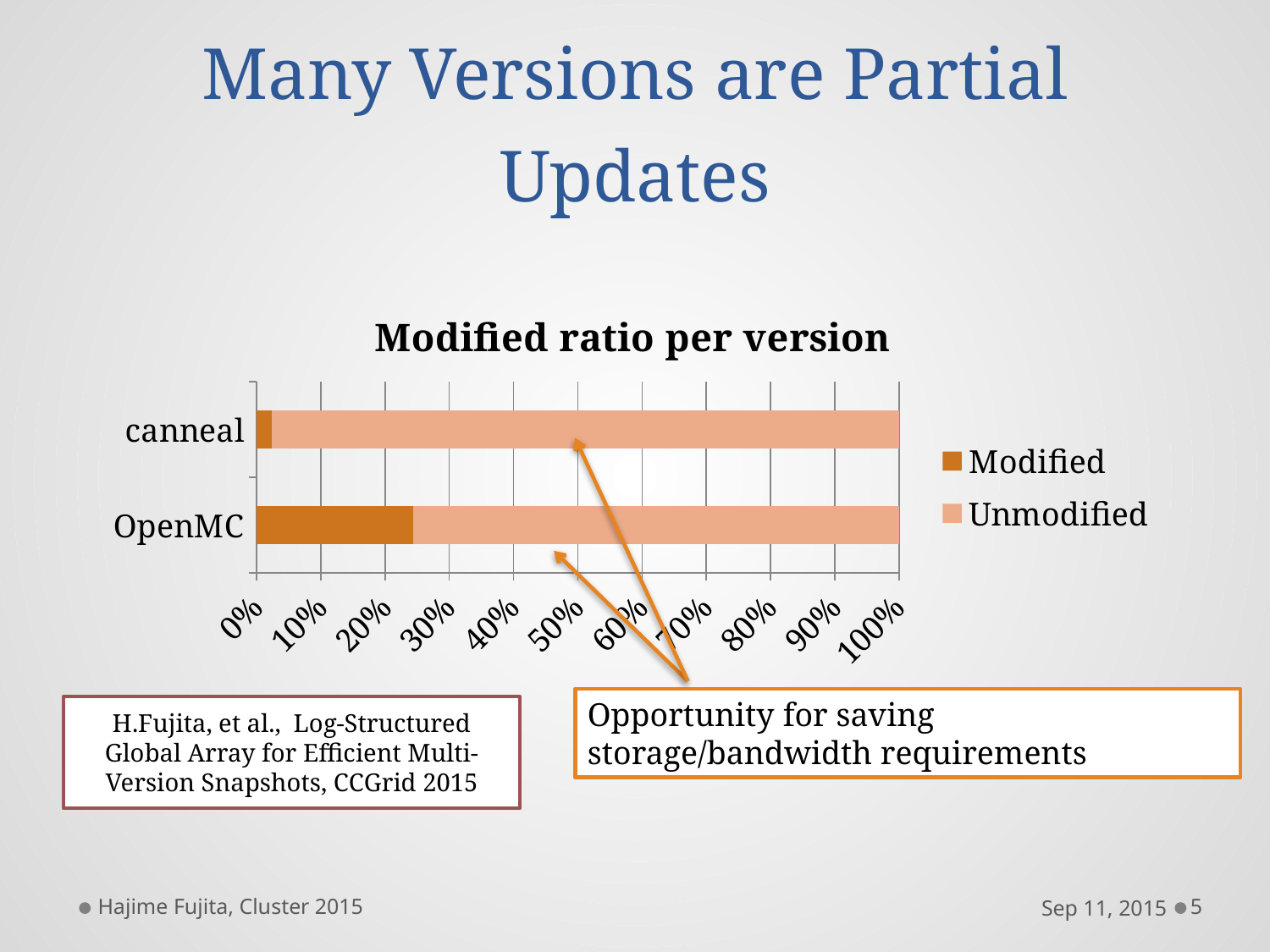
How many series does the chart's legend list? 2 What is the title of the chart? Modified ratio per version Which category has the highest Modified ratio? OpenMC Which series are listed in the chart's legend? Modified and Unmodified How many categories are plotted on the chart? 2 Which category has the larger Modified share, canneal or OpenMC? OpenMC Which category has the larger Unmodified share? canneal What kind of chart is shown on the slide? Stacked bar chart Is the Modified value for OpenMC greater or less than 30%? less Which category has the lowest Modified ratio? canneal Is the Modified value for OpenMC greater or less than 20%? greater Is the Modified value for canneal greater or less than 10%? less